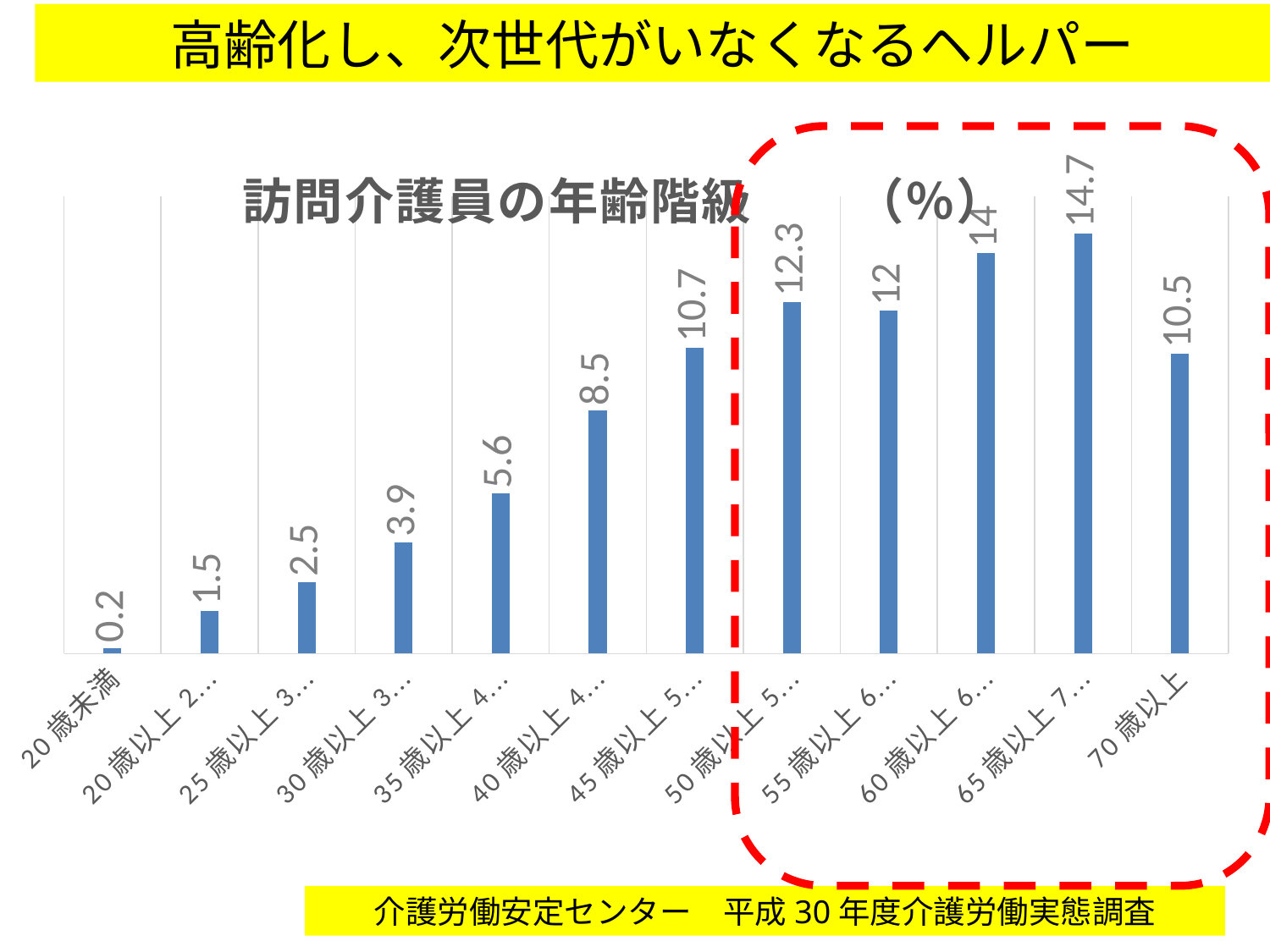
What is the value for the 70歳以上 category? 10.5 Which category has the lowest value? 20歳未満 What is the value for the category whose label begins with 65歳以上? 14.7 What is the title of the chart? 訪問介護員の年齢階級（%） What is the value for the category whose label begins with 40歳以上? 8.5 What type of chart is shown on the slide? bar chart How many age categories are shown in the chart? 12 Which category has the highest value? 65歳以上… Do the values generally rise or fall from 20歳未満 through the category beginning with 65歳以上? rise Which is larger: the value for the category beginning with 50歳以上 or the category beginning with 55歳以上? 50歳以上… What is the difference between the value for the category beginning with 65歳以上 and the value for 70歳以上? 4.2 What is the value for the 20歳未満 category? 0.2